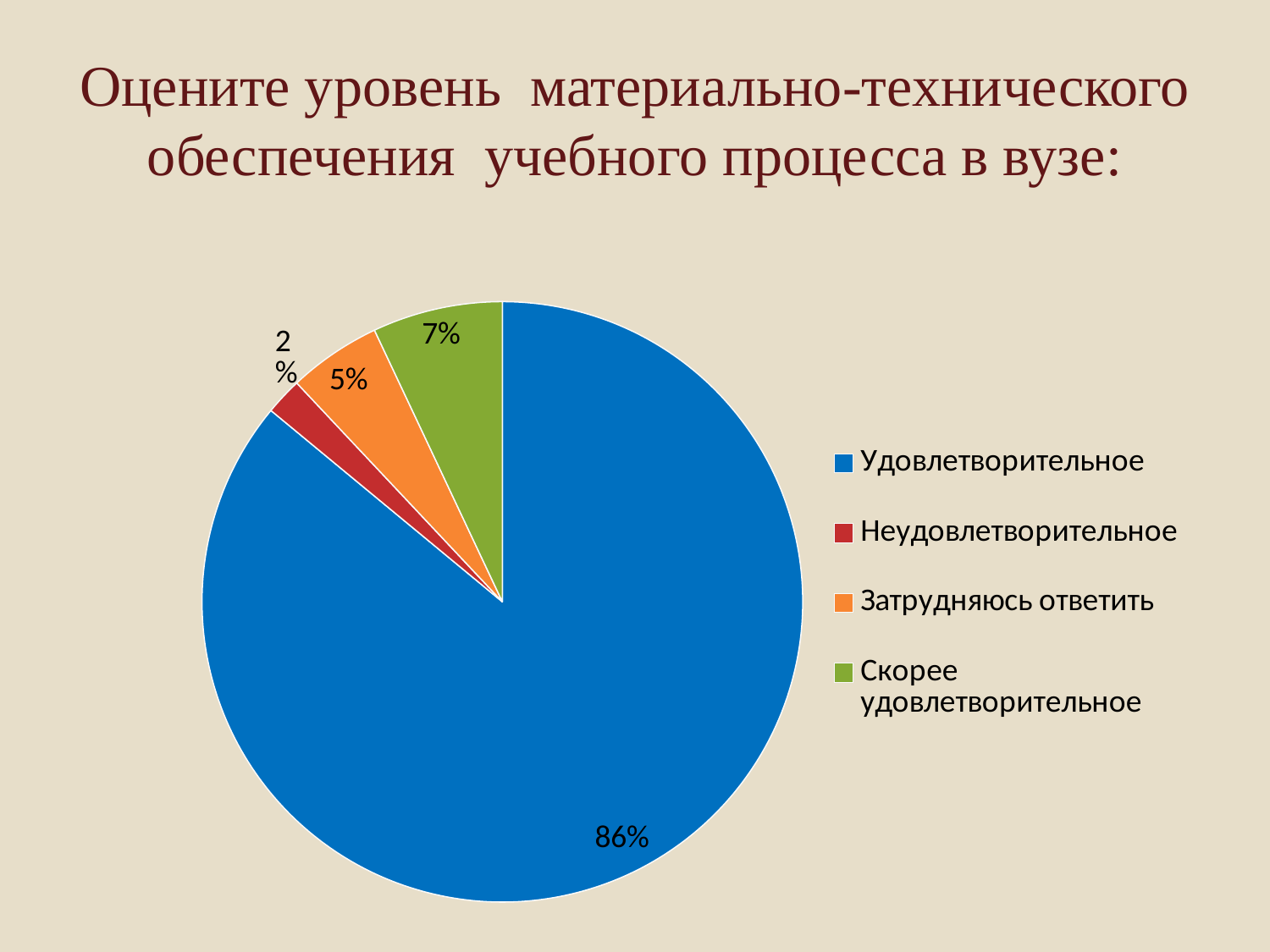
What share of the pie is labelled Скорее удовлетворительное? 7% What is the difference in percentage points between Удовлетворительное and Скорее удовлетворительное? 79 What kind of chart is shown on the slide? pie chart How many categories does the legend list? 4 What is the combined share of Неудовлетворительное and Затрудняюсь ответить? 7% Which category has the largest slice of the pie? Удовлетворительное Which category has the smallest slice of the pie? Неудовлетворительное What share of the pie is labelled Затрудняюсь ответить? 5% What share of the pie is labelled Удовлетворительное? 86% What share of the pie is labelled Неудовлетворительное? 2% Which is larger, the slice for Затрудняюсь ответить or the slice for Скорее удовлетворительное? Скорее удовлетворительное What colour is the slice for Затрудняюсь ответить? orange